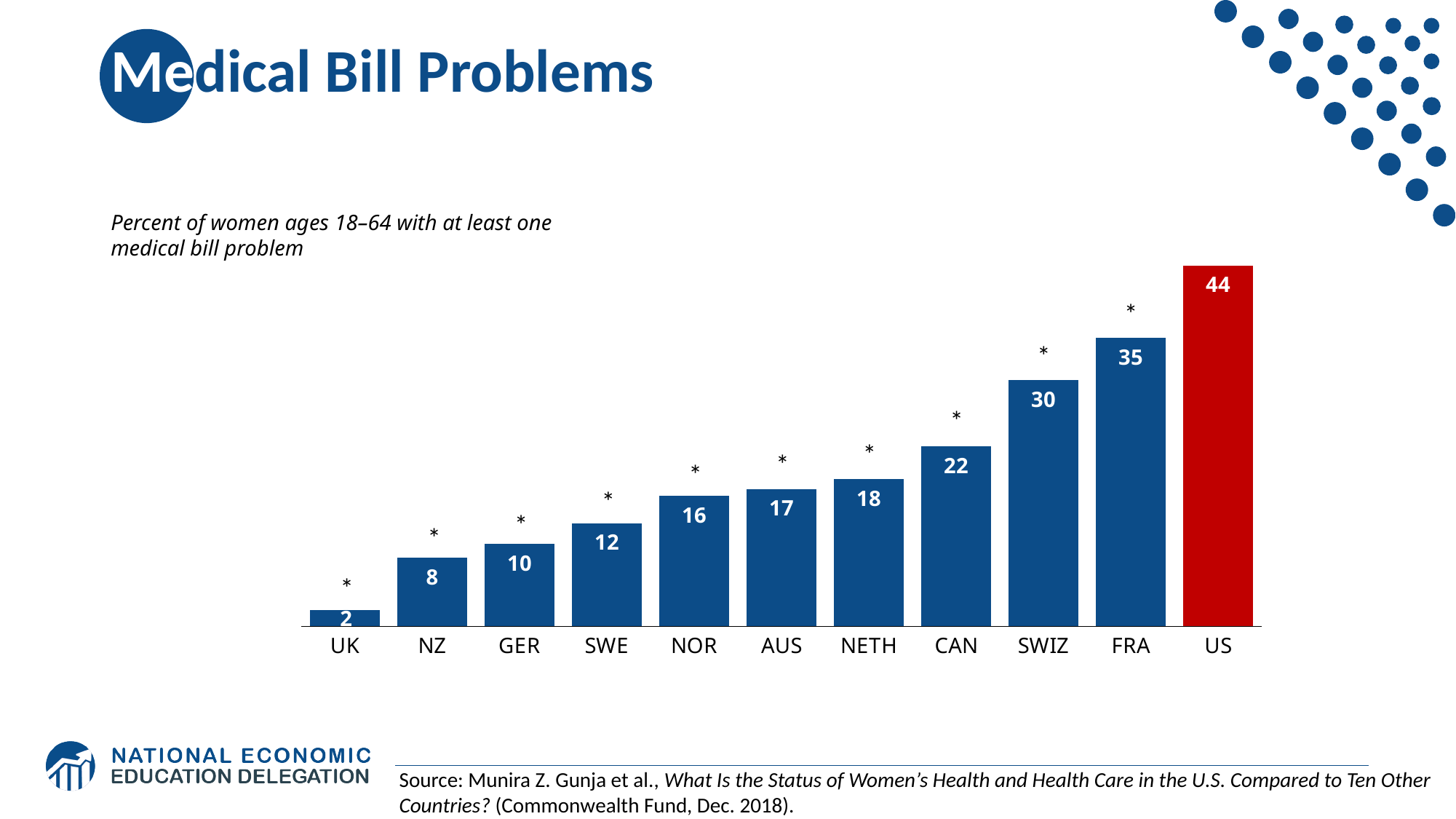
Which country has the highest value? US What is the value for Germany (GER)? 10 What is the difference between the values for the US and France (FRA)? 9 Which country's bar is coloured red rather than blue? US Which country has the lowest value? UK What is the value for Canada (CAN)? 22 How many countries are shown in the chart? 11 What is the value for the US? 44 What is the difference between the values for Switzerland (SWIZ) and the UK? 28 Do the values rise or fall from left to right along the x axis? Rise What kind of chart is shown on the slide? Bar chart Which has a larger value, Norway (NOR) or Sweden (SWE)? NOR